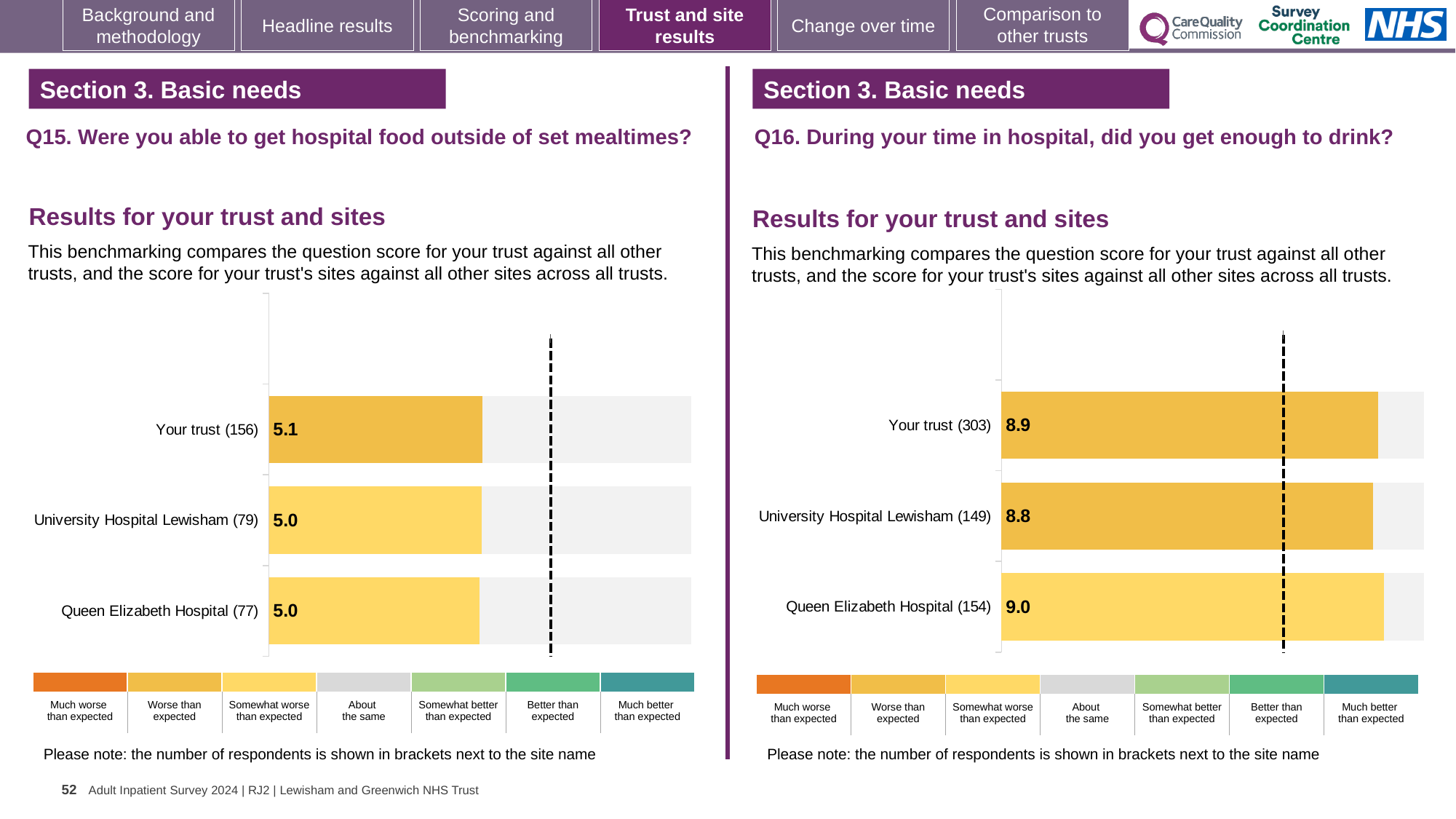
In the Q16 chart on the right, what is the difference between the scores for Queen Elizabeth Hospital and University Hospital Lewisham? 0.2 How many categories (bars) are shown in the Q15 chart on the left? 3 In the Q16 chart on the right, what is the score for University Hospital Lewisham? 8.8 In the Q16 chart on the right, which category has the lowest score? University Hospital Lewisham In the Q15 chart on the left, what is the difference between the scores for Your trust and University Hospital Lewisham? 0.1 What type of chart is used for the Q16 results on the right? bar chart In the Q15 chart on the left, what is the score for Your trust? 5.1 In the Q16 chart on the right, which category has the highest score? Queen Elizabeth Hospital In the Q15 chart on the left, which category has the highest score? Your trust In the Q15 chart on the left, what is the score for Queen Elizabeth Hospital? 5.0 In the Q16 chart on the right, is the score for Your trust larger or smaller than the score for University Hospital Lewisham? larger In the Q16 chart on the right, what is the score for Queen Elizabeth Hospital? 9.0